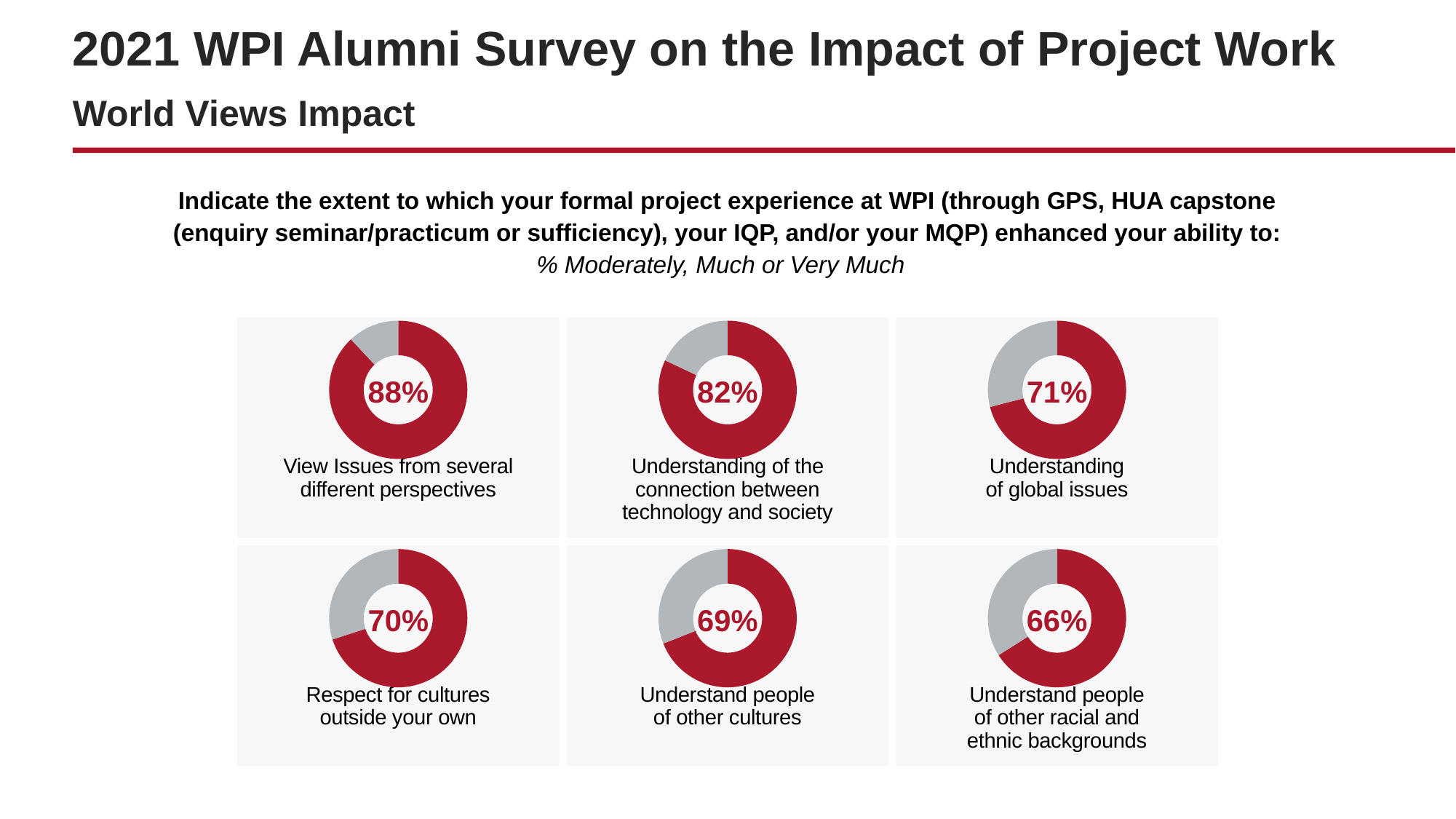
What percentage is shown for 'Understand people of other racial and ethnic backgrounds'? 66% What percentage is shown for 'Respect for cultures outside your own'? 70% How many donut charts are shown on the slide? 6 Which item has the lowest percentage on the slide? Understand people of other racial and ethnic backgrounds What colour is used for the filled (percentage) portion of each donut chart? Red Which is larger: the percentage for 'Understanding of global issues' or for 'Understand people of other racial and ethnic backgrounds'? Understanding of global issues What kind of chart is used to display each percentage on the slide? Donut (pie) chart What percentage is shown for 'View Issues from several different perspectives'? 88% What is the difference between the percentage for 'View Issues from several different perspectives' and 'Understand people of other cultures'? 19% What percentage is shown for 'Understanding of the connection between technology and society'? 82% What percentage is shown for 'Understanding of global issues'? 71% Which item has the highest percentage on the slide? View Issues from several different perspectives